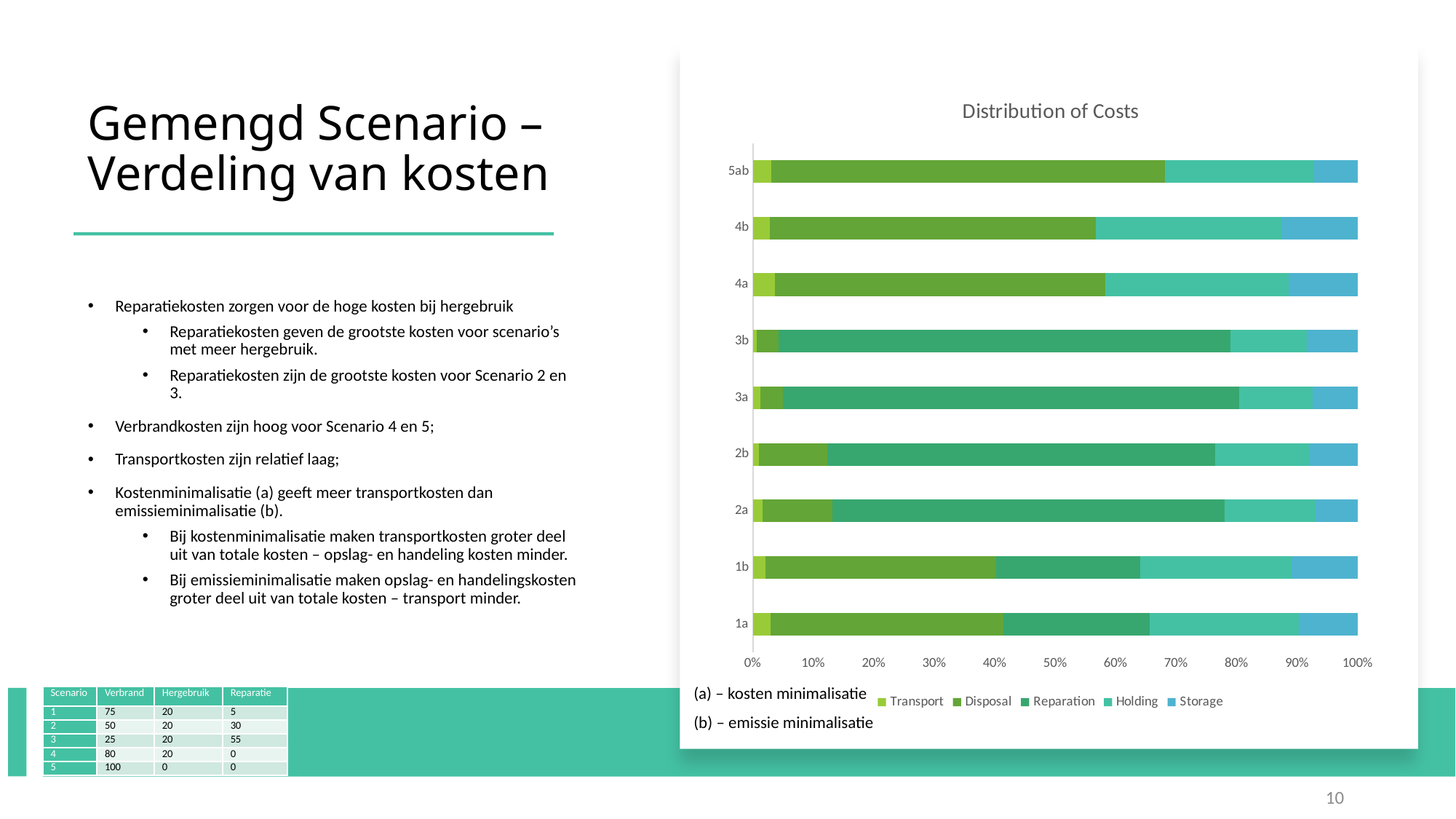
What does each stacked bar in the chart total? 100% How many series does the chart legend list? 5 Is the Disposal share for 5ab greater or less than 60%? greater Which category has the largest Disposal share? 5ab What kind of chart is shown on the slide? Stacked bar chart Which series are listed in the chart legend? Transport, Disposal, Reparation, Holding, Storage How many categories (bars) are plotted in the chart? 9 Which is larger, the Disposal share for 5ab or the Disposal share for 1a? 5ab Which is larger, the Reparation share for 3b or the Reparation share for 1b? 3b Is the Disposal share for 1a greater or less than 30%? greater What is the title of the chart? Distribution of Costs Is the Reparation share for 2b greater or less than 50%? greater